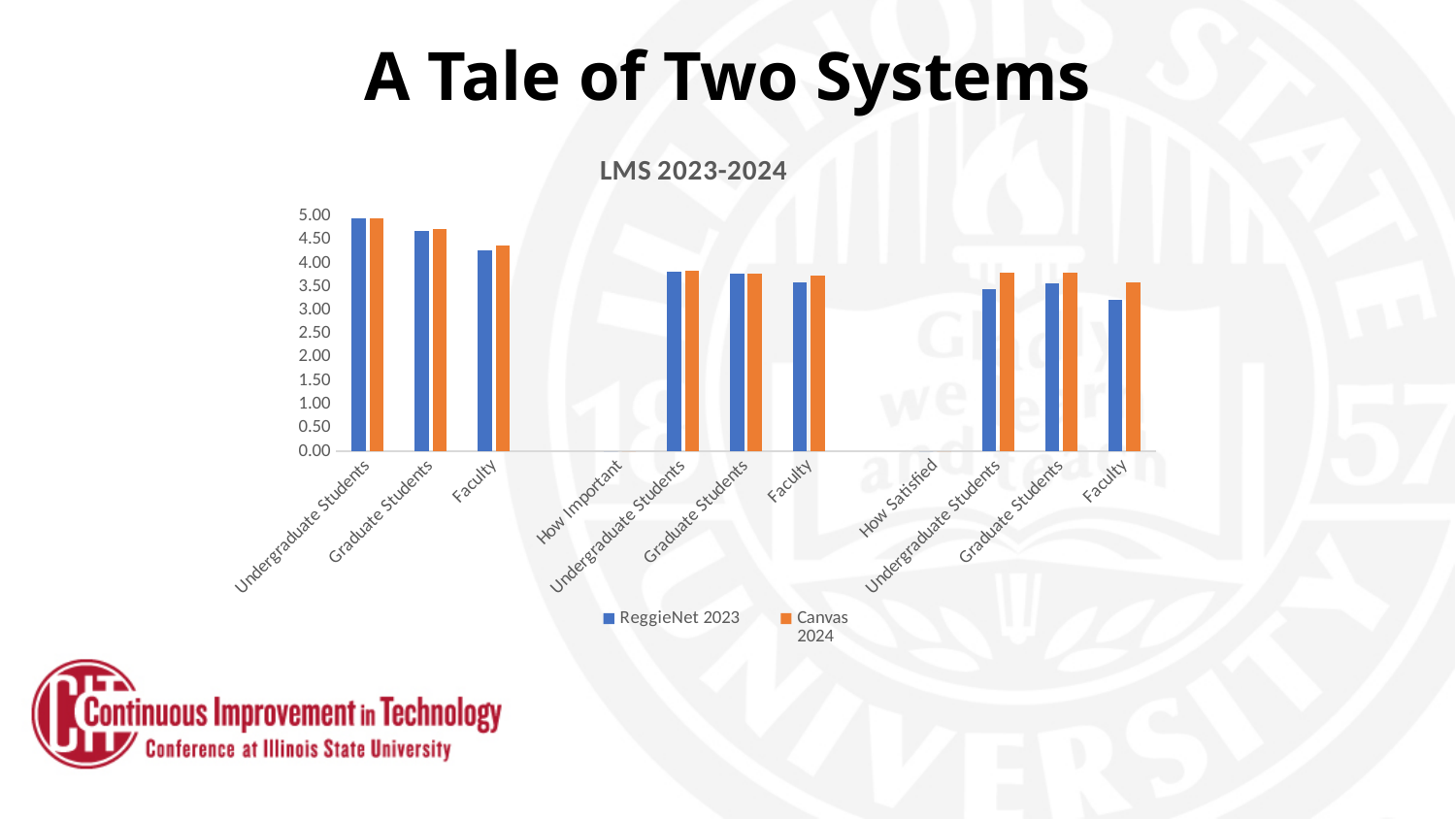
Is the ReggieNet 2023 value for the leftmost Faculty category greater or less than 4.50? less For the rightmost Undergraduate Students category, which series has the larger value, ReggieNet 2023 or Canvas 2024? Canvas 2024 Is the ReggieNet 2023 value for the leftmost Undergraduate Students category greater or less than 4.50? greater Which series is shown in orange in the chart? Canvas 2024 What is the title of the chart? LMS 2023-2024 Is the ReggieNet 2023 value for the rightmost Faculty category greater or less than 3.50? less What type of chart is shown on the slide? bar chart For the rightmost Faculty category, which series has the larger value, ReggieNet 2023 or Canvas 2024? Canvas 2024 How many category labels appear along the x axis of the chart? 11 Which category has the lowest ReggieNet 2023 value in the chart? Faculty (rightmost group) How many series does the chart legend list? 2